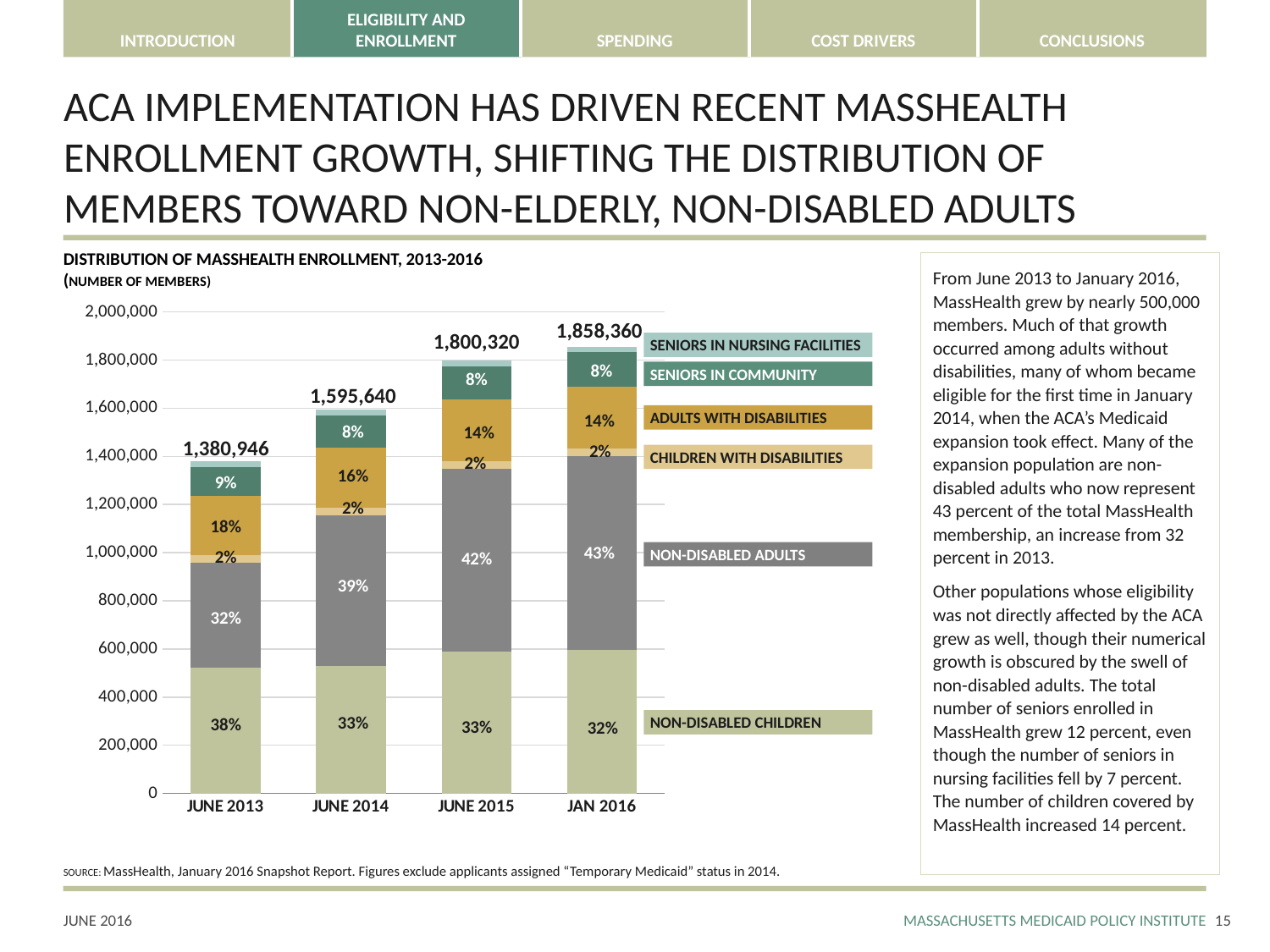
How many time periods are shown on the x axis? 4 What percentage of members were non-disabled children in June 2014? 33% Which time period has the lowest total enrollment? JUNE 2013 What percentage of members were non-disabled adults in June 2015? 42% How many member categories does the legend list? 6 Which time period has the highest total enrollment? JAN 2016 By how many members did total enrollment grow from June 2013 to January 2016? 477,414 Does total enrollment rise or fall from June 2013 to January 2016? rise Is the total enrollment for June 2014 greater or less than 1,600,000? less What is the total MassHealth enrollment shown for June 2013? 1,380,946 What percentage of members were adults with disabilities in June 2013? 18% What is the total MassHealth enrollment shown for January 2016? 1,858,360